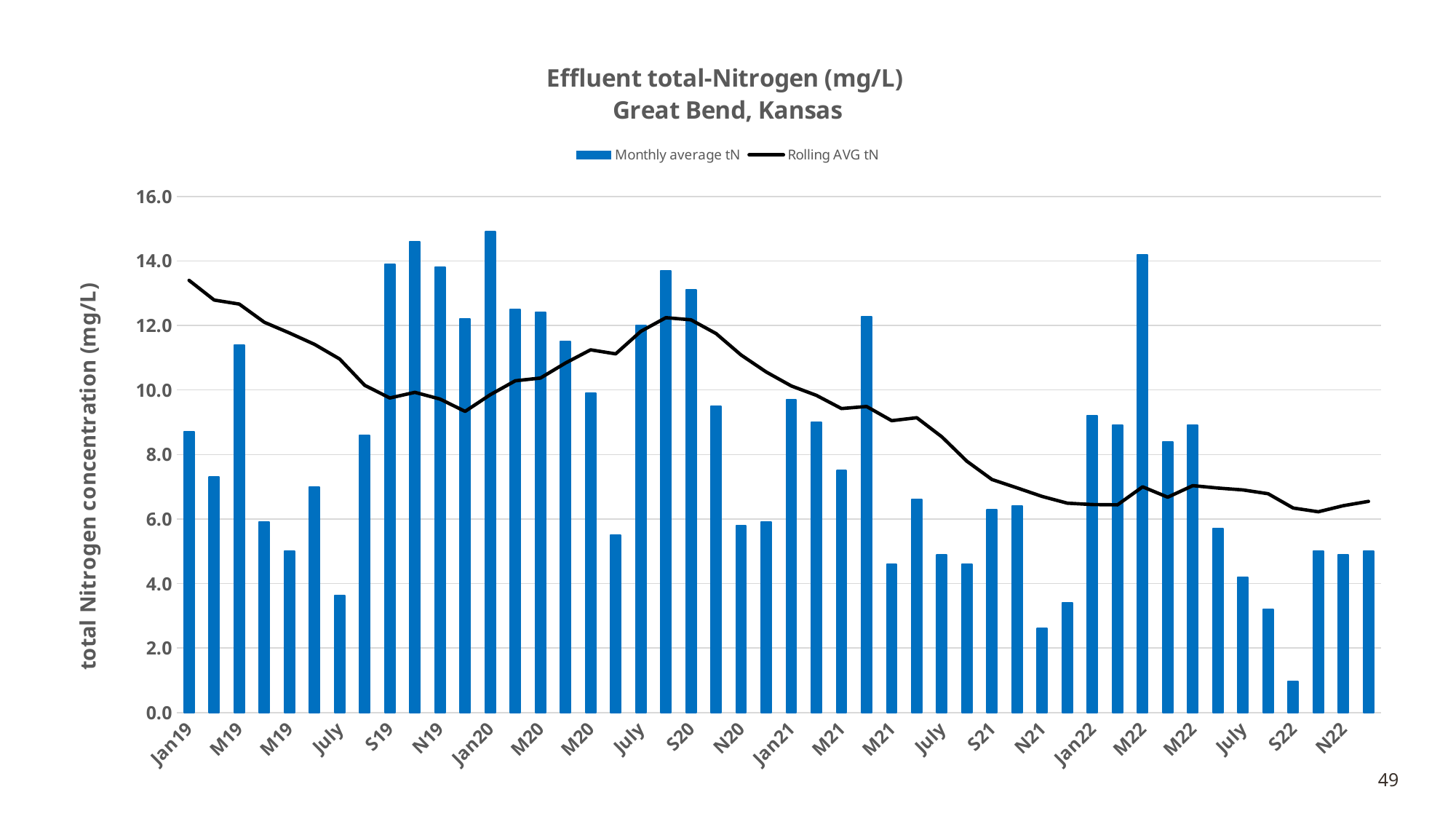
Which has the larger Monthly average tN bar, N20 or N21? N20 How many series does the legend list? 2 Is the Monthly average tN value for S22 greater or less than 2.0? less Which has the larger Monthly average tN bar, Jan20 or Jan21? Jan20 Is the Monthly average tN value for Jan20 greater or less than 14.0? greater Is the Monthly average tN value for N21 greater or less than 4.0? less What is the title of the y axis? total Nitrogen concentration (mg/L) What kind of chart is shown on the slide? A bar chart with a line overlay What are the two series named in the legend? Monthly average tN and Rolling AVG tN Which month has the lowest Monthly average tN bar? S22 Does the Rolling AVG tN line generally rise or fall from Jan19 to the end of the chart? fall